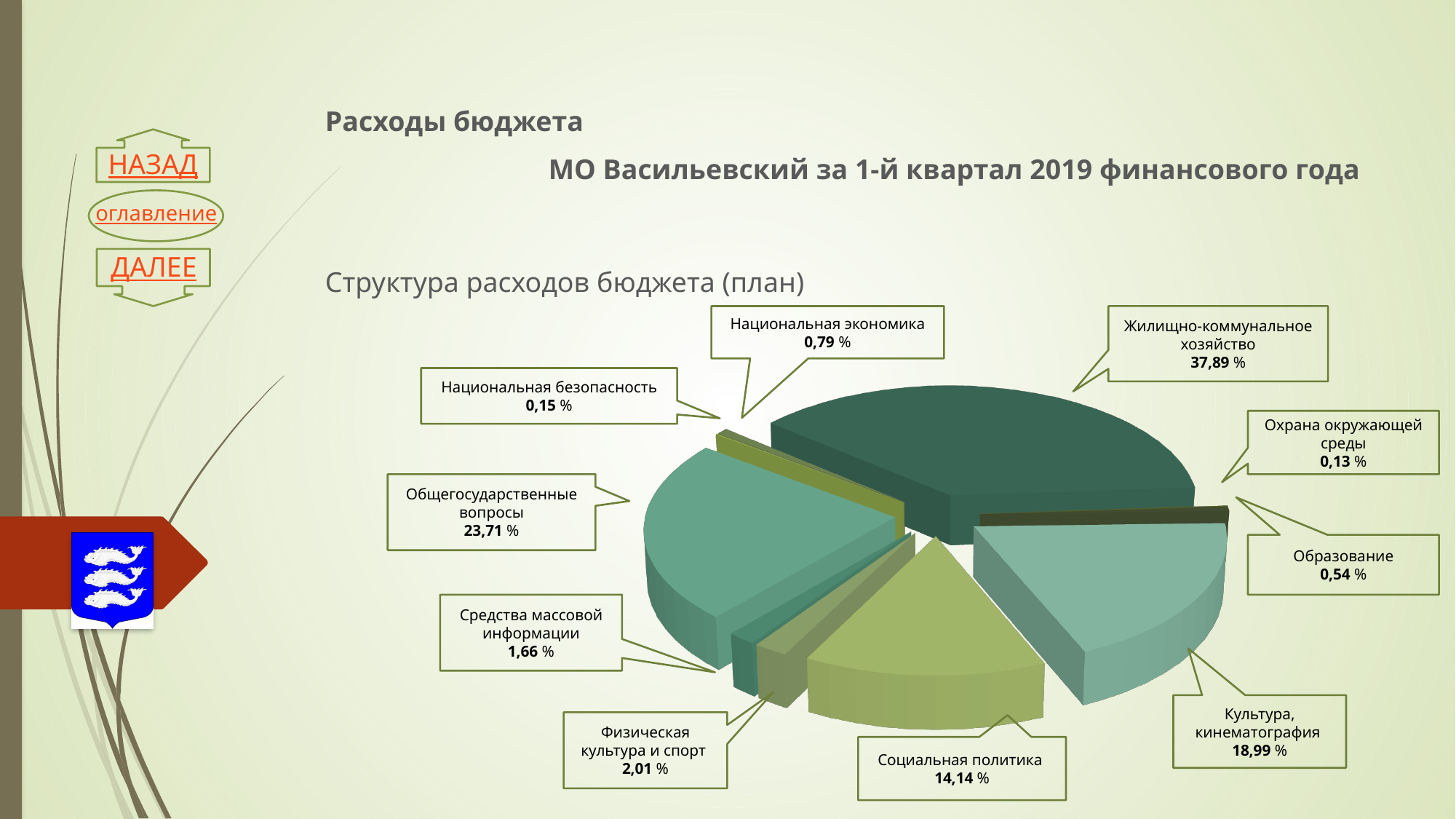
What is the title of the chart? Структура расходов бюджета (план) Which category has the largest share of the pie? Жилищно-коммунальное хозяйство How many categories does the pie chart show? 10 What is the value for Общегосударственные вопросы? 23,71 % What is the value for Социальная политика? 14,14 % What is the difference between the shares of Жилищно-коммунальное хозяйство and Общегосударственные вопросы? 14,18 % What kind of chart is shown on the slide? Pie chart What share of the budget expenses is Жилищно-коммунальное хозяйство? 37,89 % Which category has the smallest share of the pie? Охрана окружающей среды What is the value for Физическая культура и спорт? 2,01 % Which is larger: Культура, кинематография or Социальная политика? Культура, кинематография What is the difference between the shares of Культура, кинематография and Социальная политика? 4,85 %